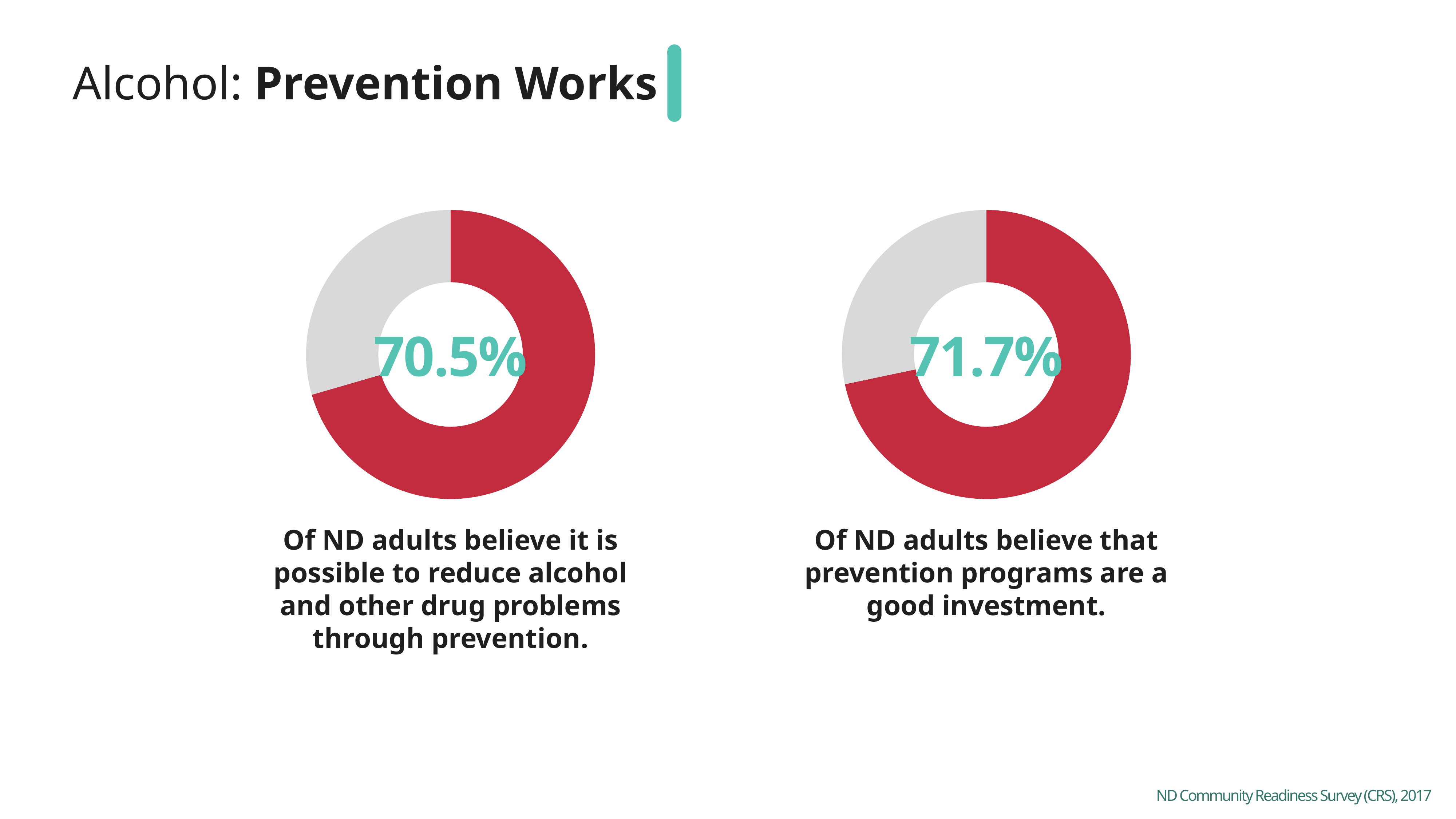
What is the title of the slide containing the two donut charts? Alcohol: Prevention Works What is the difference in percentage points between the right chart's value (71.7%) and the left chart's value (70.5%)? 1.2 percentage points On the left chart, is the value for ND adults who believe prevention can reduce alcohol and other drug problems greater or less than 50%? greater On the right chart, what share of the donut is not filled in red (the grey portion)? 28.3% On the left chart, what percentage of ND adults believe it is possible to reduce alcohol and other drug problems through prevention? 70.5% On the right chart, is the value for ND adults who believe prevention programs are a good investment greater or less than 75%? less What kind of chart is used on this slide to show the percentages? donut (pie) chart How many charts are shown on the slide? 2 On the left chart, what share of the donut is not filled in red (the grey portion)? 29.5% On the right chart, what percentage of ND adults believe that prevention programs are a good investment? 71.7% Which chart shows the higher percentage, the left chart (reducing problems through prevention) or the right chart (prevention programs are a good investment)? the right chart (71.7%) What colour is used for the filled (highlighted) portion of each donut chart? red